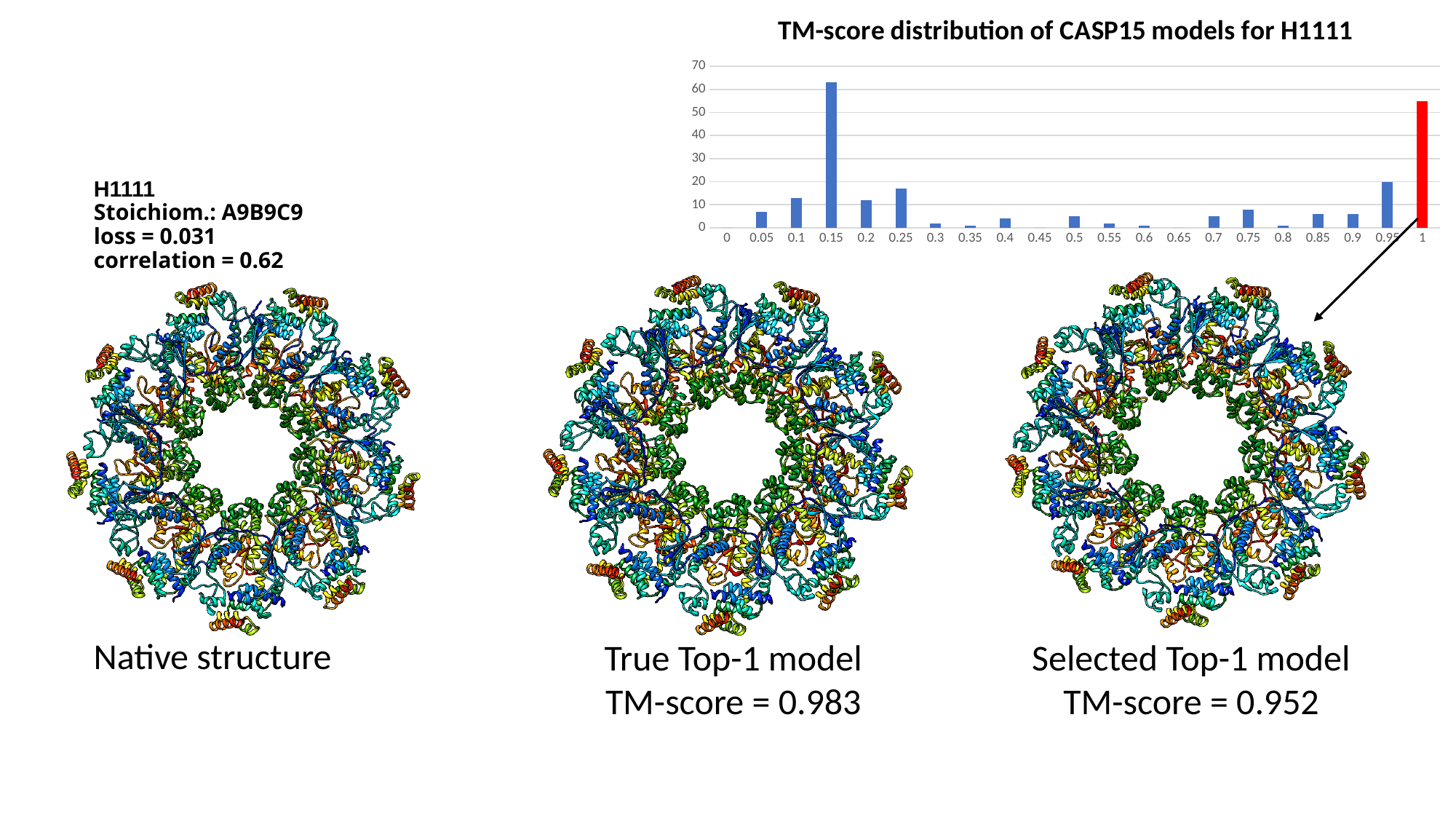
Is the value for the 0.25 bin greater or less than 10? greater Which TM-score bin is highlighted with a red bar? 1 What kind of chart is shown on the slide? bar chart Which TM-score bin has the tallest bar in the chart? 0.15 Is the value for the 1 bin greater or less than 60? less Is the value for the 0.15 bin greater or less than 50? greater How many TM-score bins are labelled on the x axis of the chart? 21 Which bin has the larger value, 0.95 or 0.25? 0.95 What is the title of the chart? TM-score distribution of CASP15 models for H1111 Which bin has the larger value, 0.15 or 1? 0.15